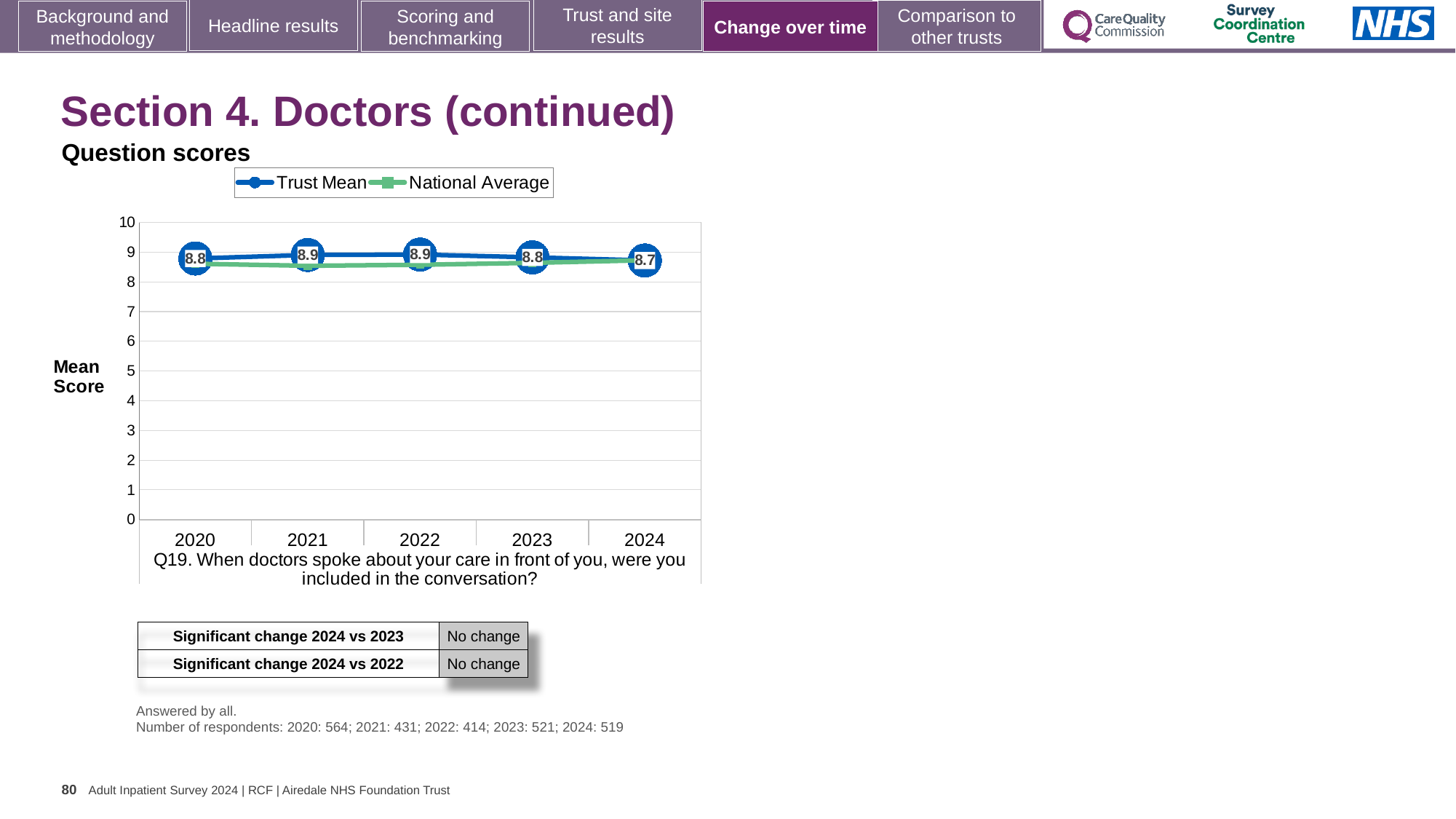
Is the National Average value for 2023 greater or less than 9? less How many series does the legend list? 2 What is the difference between the Trust Mean score in 2021 and in 2024? 0.2 Does the Trust Mean score rise or fall from 2022 to 2024? Fall What is the Trust Mean score for 2024? 8.7 What kind of chart is shown? Line chart What is the Trust Mean score for 2020? 8.8 Is the National Average value for 2020 greater or less than 8? greater How many years are plotted on the x axis? 5 What is the Trust Mean score for 2022? 8.9 Which is larger, the Trust Mean score for 2022 or for 2024? 2022 In which year is the Trust Mean score lowest? 2024